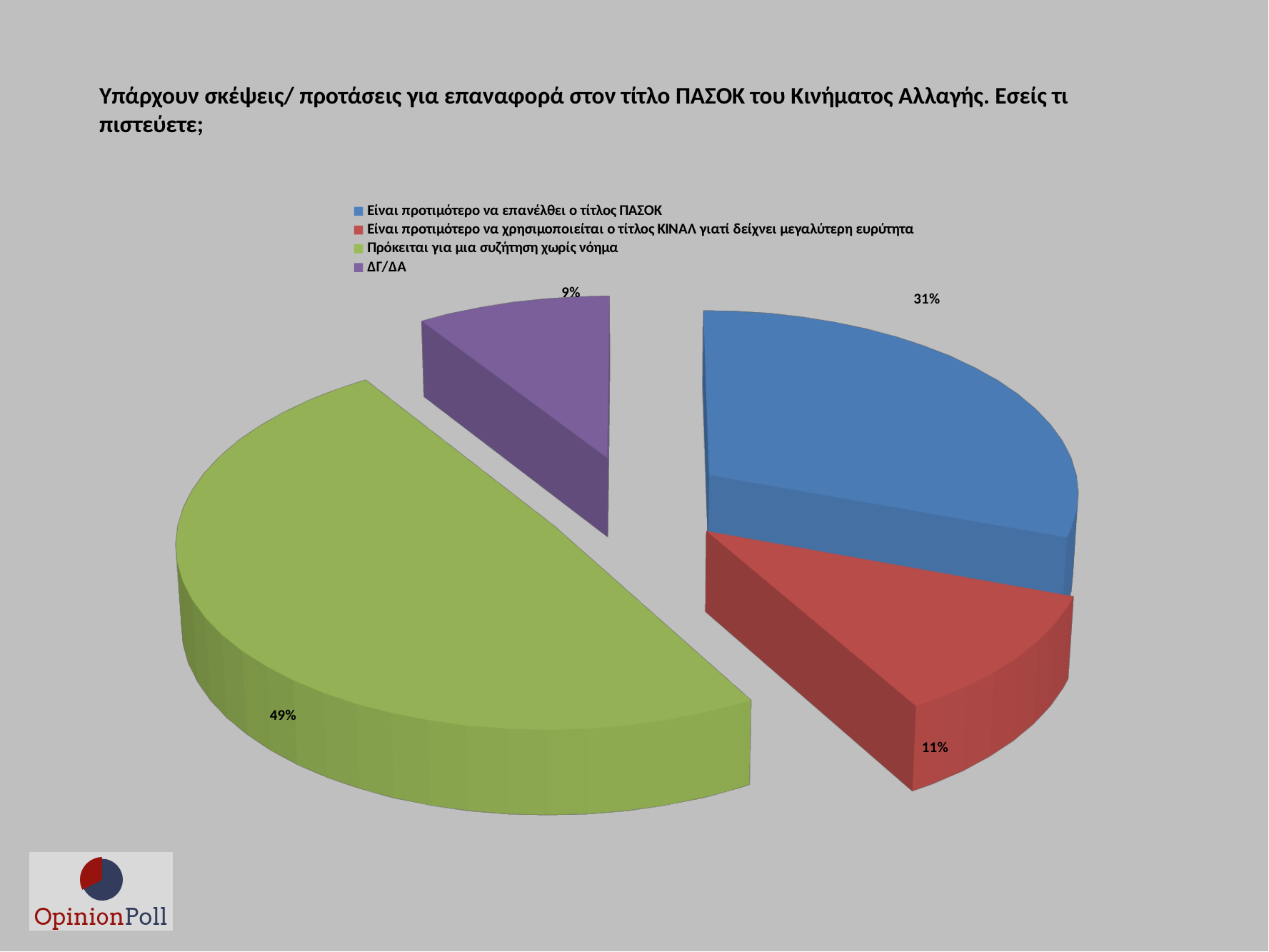
What percentage is shown for "Πρόκειται για μια συζήτηση χωρίς νόημα"? 49% What colour is the slice for "Πρόκειται για μια συζήτηση χωρίς νόημα"? Green What colour is the slice for "ΔΓ/ΔΑ"? Purple What percentage is shown for "ΔΓ/ΔΑ"? 9% Which category has the largest share of the pie? Πρόκειται για μια συζήτηση χωρίς νόημα What percentage is shown for "Είναι προτιμότερο να επανέλθει ο τίτλος ΠΑΣΟΚ"? 31% Which is larger: the share for "Είναι προτιμότερο να επανέλθει ο τίτλος ΠΑΣΟΚ" or the share for "Είναι προτιμότερο να χρησιμοποιείται ο τίτλος ΚΙΝΑΛ γιατί δείχνει μεγαλύτερη ευρύτητα"? Είναι προτιμότερο να επανέλθει ο τίτλος ΠΑΣΟΚ What percentage is shown for "Είναι προτιμότερο να χρησιμοποιείται ο τίτλος ΚΙΝΑΛ γιατί δείχνει μεγαλύτερη ευρύτητα"? 11% What is the difference in percentage points between "Πρόκειται για μια συζήτηση χωρίς νόημα" and "Είναι προτιμότερο να επανέλθει ο τίτλος ΠΑΣΟΚ"? 18 How many categories does the pie chart have? 4 Which category has the smallest share of the pie? ΔΓ/ΔΑ What kind of chart is shown on the slide? Pie chart